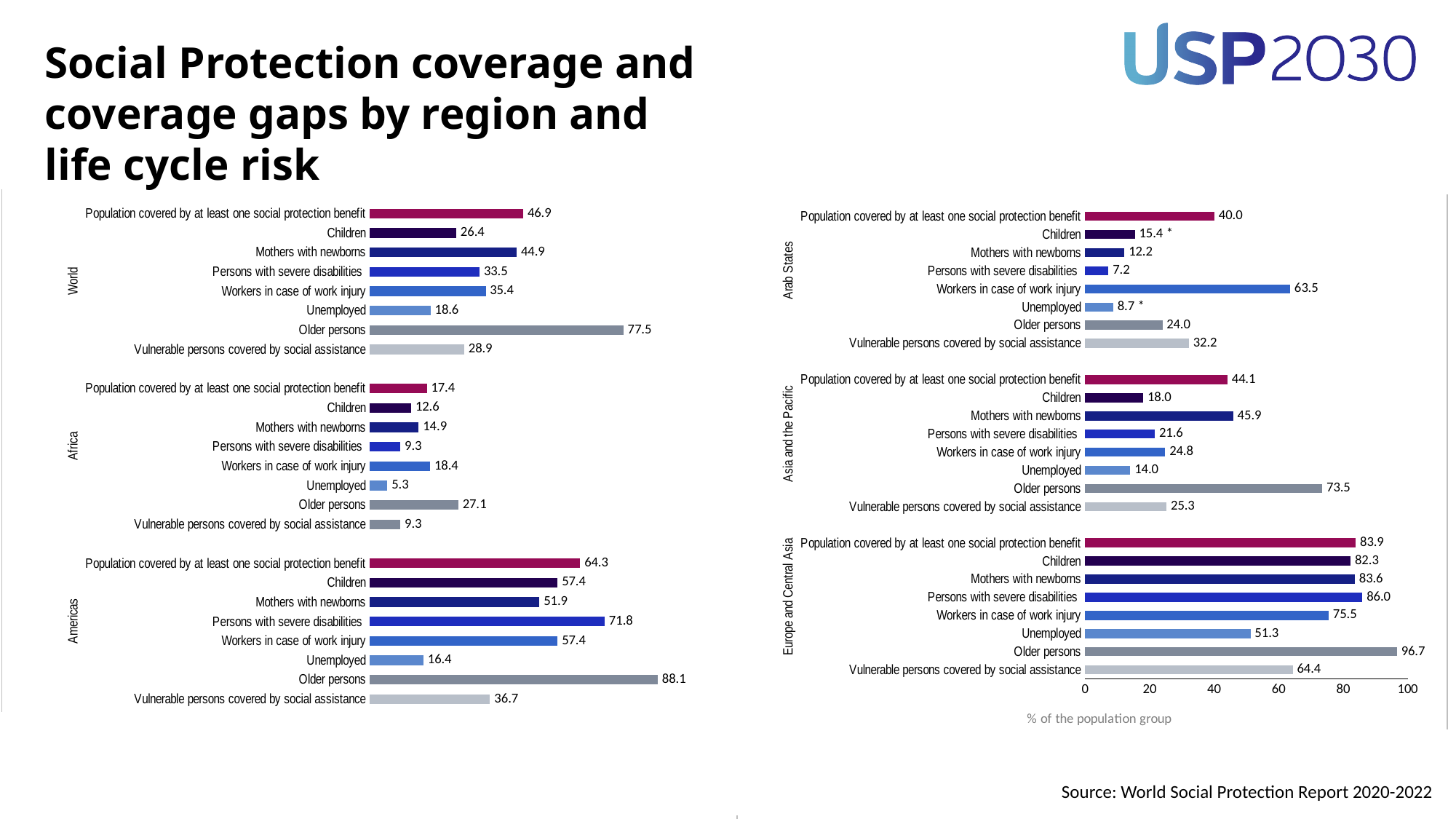
What type of chart is used on this slide? Bar chart In the right chart, what is the difference between Mothers with newborns and Children in the Asia and the Pacific group? 27.9 How many categories are shown for each region in the left chart? 8 In the left chart, which category has the highest value in the Americas group? Older persons In the left chart, what is the value for Older persons in the World group? 77.5 In the right chart, what is the value for Workers in case of work injury in the Arab States group? 63.5 In the right chart, is the value for Unemployed in the Europe and Central Asia group greater or less than 40? greater In the right chart, what is the value for Older persons in the Europe and Central Asia group? 96.7 In the left chart, which is larger in the Americas group: Persons with severe disabilities or Mothers with newborns? Persons with severe disabilities In the left chart, what is the value for Unemployed in the Africa group? 5.3 In the right chart, which category has the lowest value in the Arab States group? Persons with severe disabilities In the left chart, what is the difference between Older persons and Children in the World group? 51.1